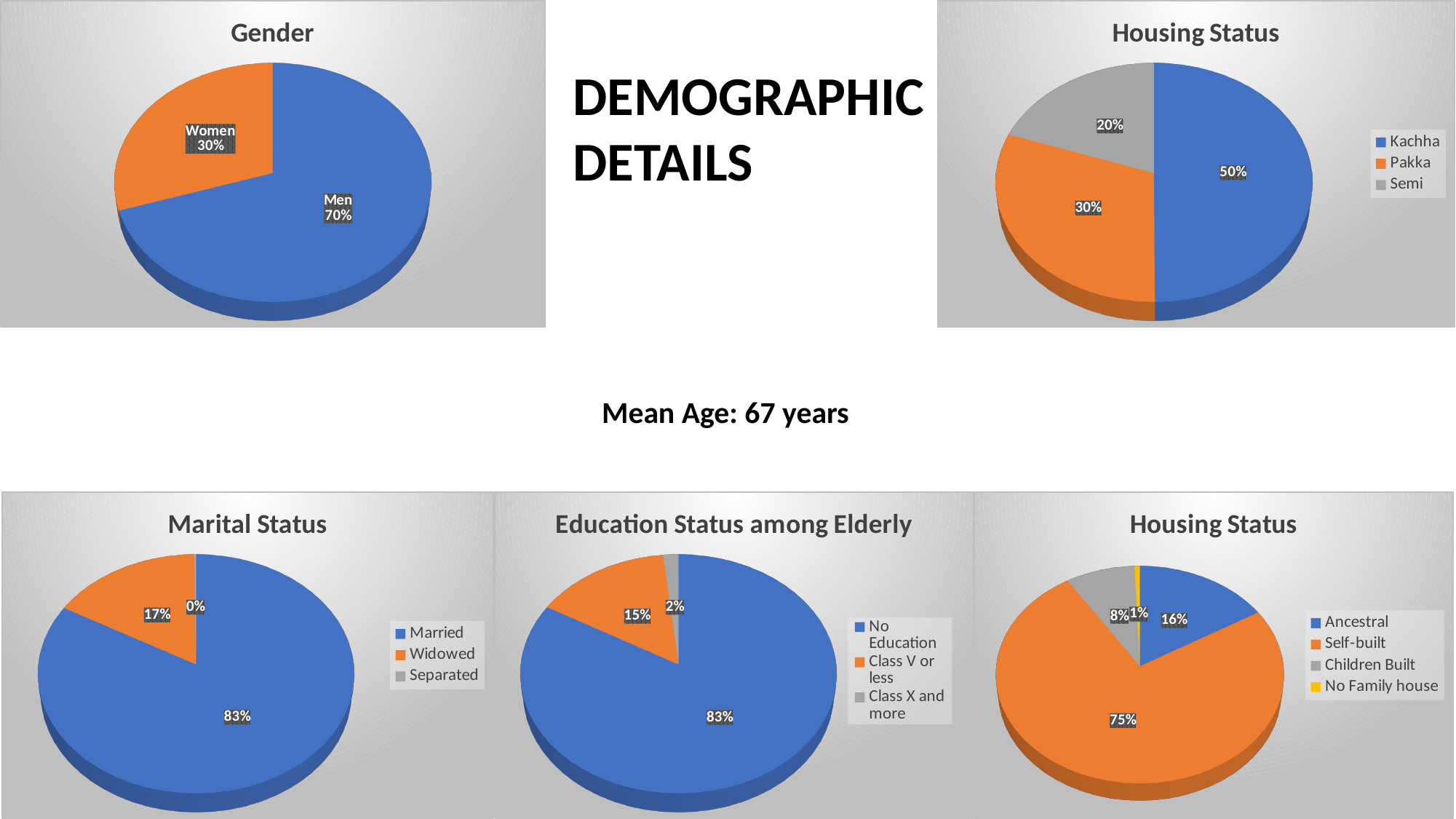
In the Housing Status chart at the bottom right, which category has the largest share? Self-built In the Housing Status chart at the top right, what is the difference between the Pakka and Semi shares? 10% In the Education Status among Elderly chart, which is larger: Class V or less, or Class X and more? Class V or less In the Marital Status chart, what percentage are Widowed? 17% In the Education Status among Elderly chart, what share has No Education? 83% In the Housing Status chart at the top right, what share is Kachha? 50% What kind of chart is the Marital Status chart? Pie chart In the Gender chart, what percentage are Women? 30% In the Housing Status chart at the bottom right, what percentage is Self-built? 75% In the Gender chart, what percentage are Men? 70% In the Marital Status chart, how many categories does the legend list? 3 In the Housing Status chart at the top right, which category has the smallest share? Semi